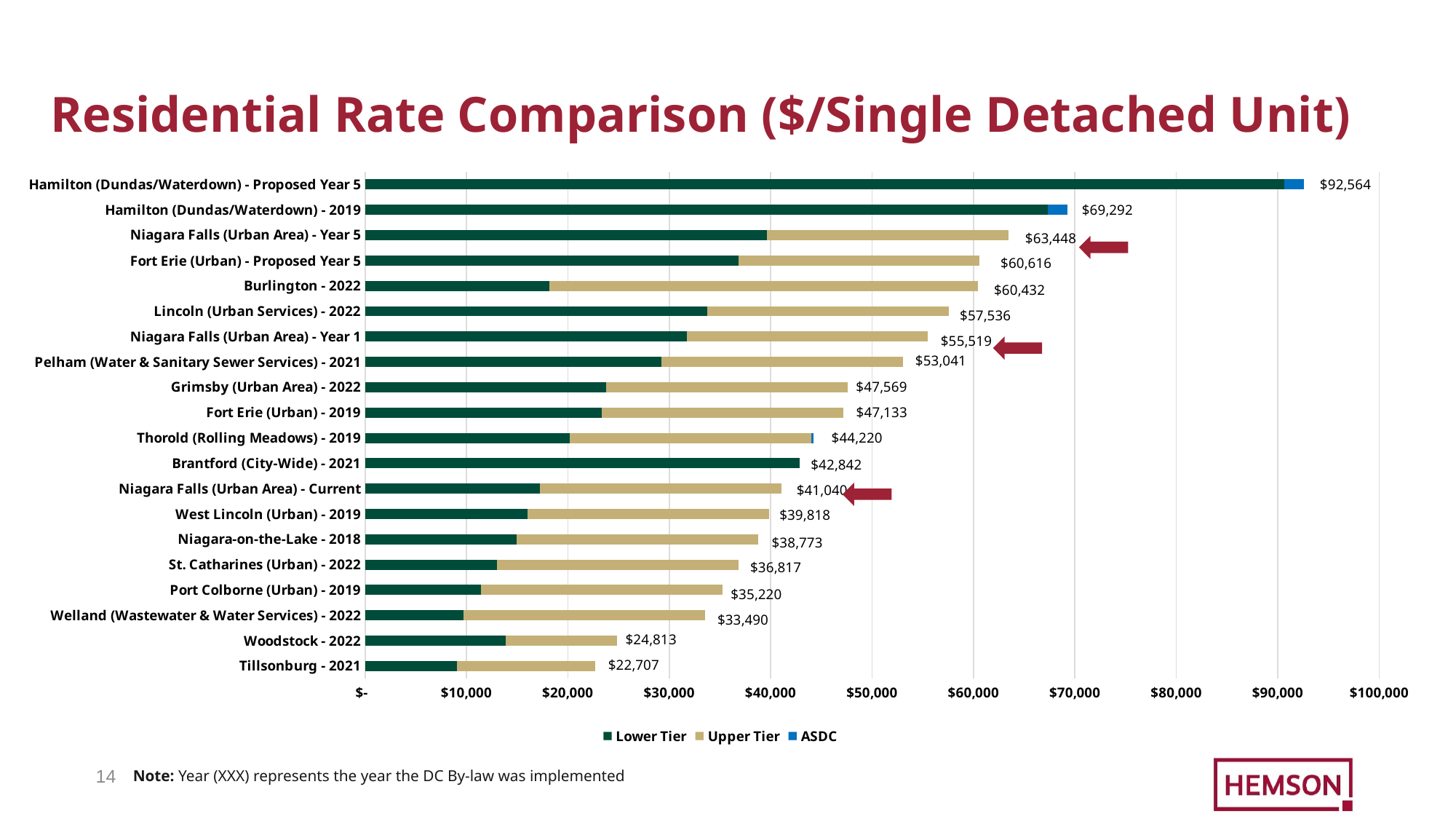
Is the Lower Tier value for Burlington - 2022 greater or less than $20,000? less How many series does the legend list? 3 How many municipalities/scenarios are listed on the chart? 20 What is the total residential rate for Hamilton (Dundas/Waterdown) - Proposed Year 5? $92,564 Which has a larger total rate, Burlington - 2022 or Lincoln (Urban Services) - 2022? Burlington - 2022 What type of chart is shown on the slide? bar chart Which series is shown in blue in the legend? ASDC What is the total residential rate for Niagara Falls (Urban Area) - Current? $41,040 What is the difference between the total rates for Niagara Falls (Urban Area) - Year 5 and Niagara Falls (Urban Area) - Current? $22,408 What is the total residential rate for Tillsonburg - 2021? $22,707 Which municipality has the highest total residential rate? Hamilton (Dundas/Waterdown) - Proposed Year 5 Which municipality has the lowest total residential rate? Tillsonburg - 2021